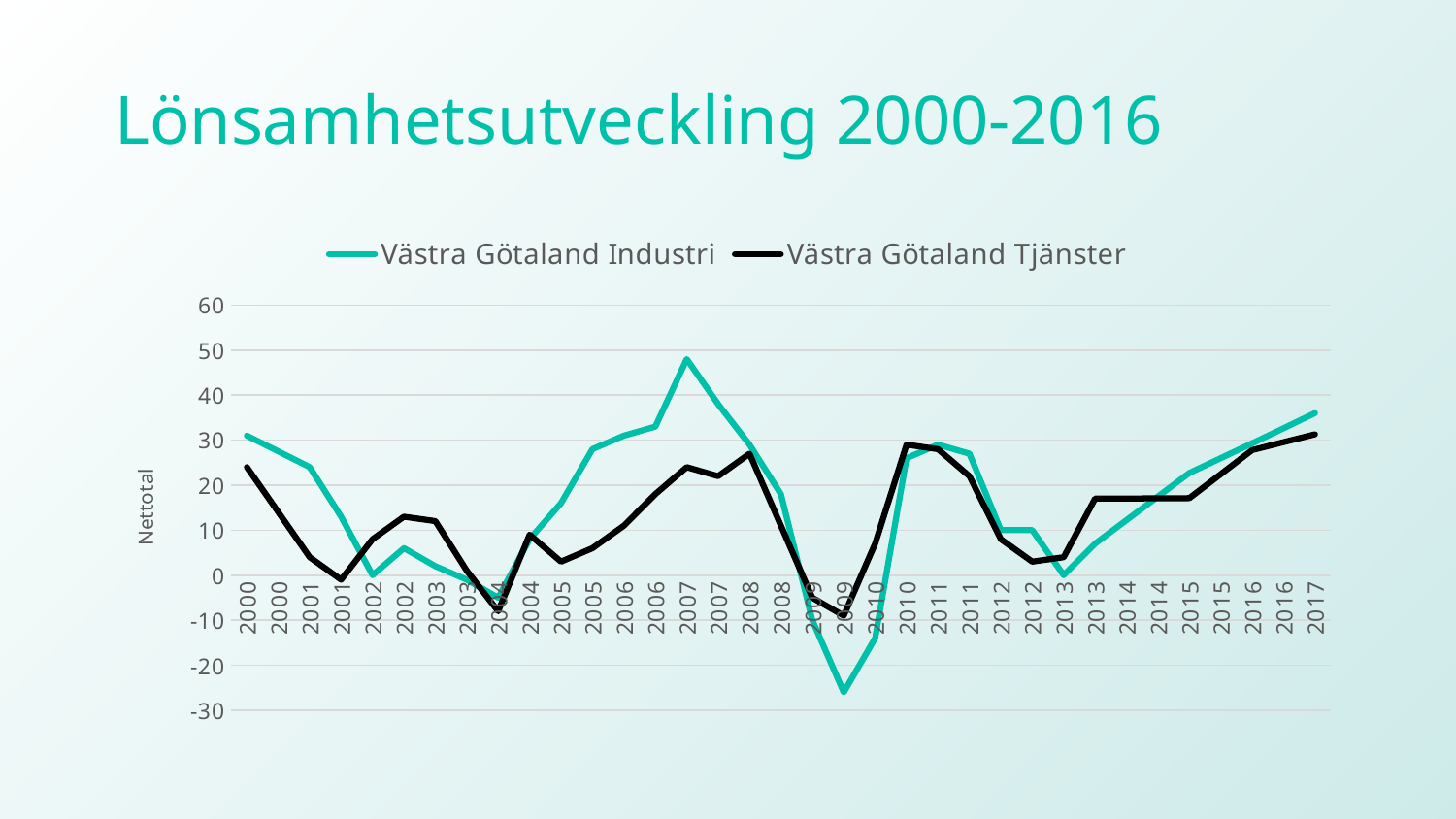
Is the peak value of Västra Götaland Industri in 2007 greater or less than 40? greater Is the value of Västra Götaland Industri at the last point (2017) greater or less than 30? greater How many series does the legend list? 2 What is the title of the chart on the slide? Lönsamhetsutveckling 2000-2016 What kind of chart is shown on the slide? line chart Does the Västra Götaland Industri line rise or fall from 2013 to 2017? rise At the 2007 peak, which series has the higher value, Västra Götaland Industri or Västra Götaland Tjänster? Västra Götaland Industri In which year does the Västra Götaland Industri line reach its lowest value? 2009 In which year does the Västra Götaland Industri line reach its highest value? 2007 At the low point in 2009, which series has the higher value, Västra Götaland Industri or Västra Götaland Tjänster? Västra Götaland Tjänster What is the label on the vertical axis? Nettotal Is the lowest value of Västra Götaland Industri in 2009 greater or less than -20? less